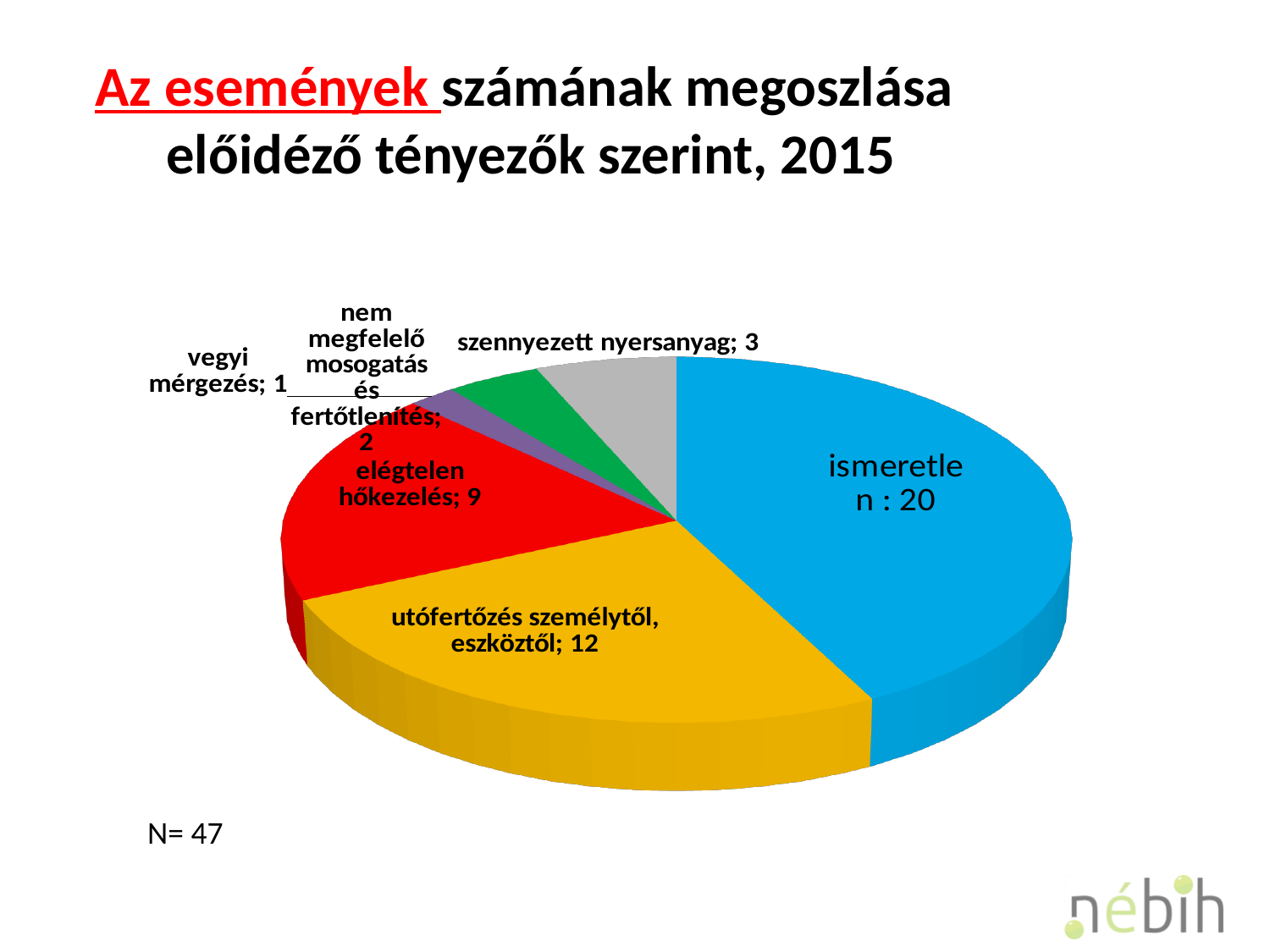
What is the value for 'utófertőzés személytől, eszköztől'? 12 How many events are attributed to 'ismeretlen' in the pie chart? 20 What is the value for 'nem megfelelő mosogatás és fertőtlenítés'? 2 What is the value for 'szennyezett nyersanyag'? 3 Which is larger: 'elégtelen hőkezelés' or 'szennyezett nyersanyag'? elégtelen hőkezelés What is the difference between the values for 'ismeretlen' and 'utófertőzés személytől, eszköztől'? 8 Which category has the smallest slice of the pie? vegyi mérgezés Which category has the largest slice of the pie? ismeretlen What type of chart is shown on the slide? pie chart What total number of events (N) is stated on the slide? 47 What is the value for 'elégtelen hőkezelés'? 9 How many categories does the pie chart have? 6